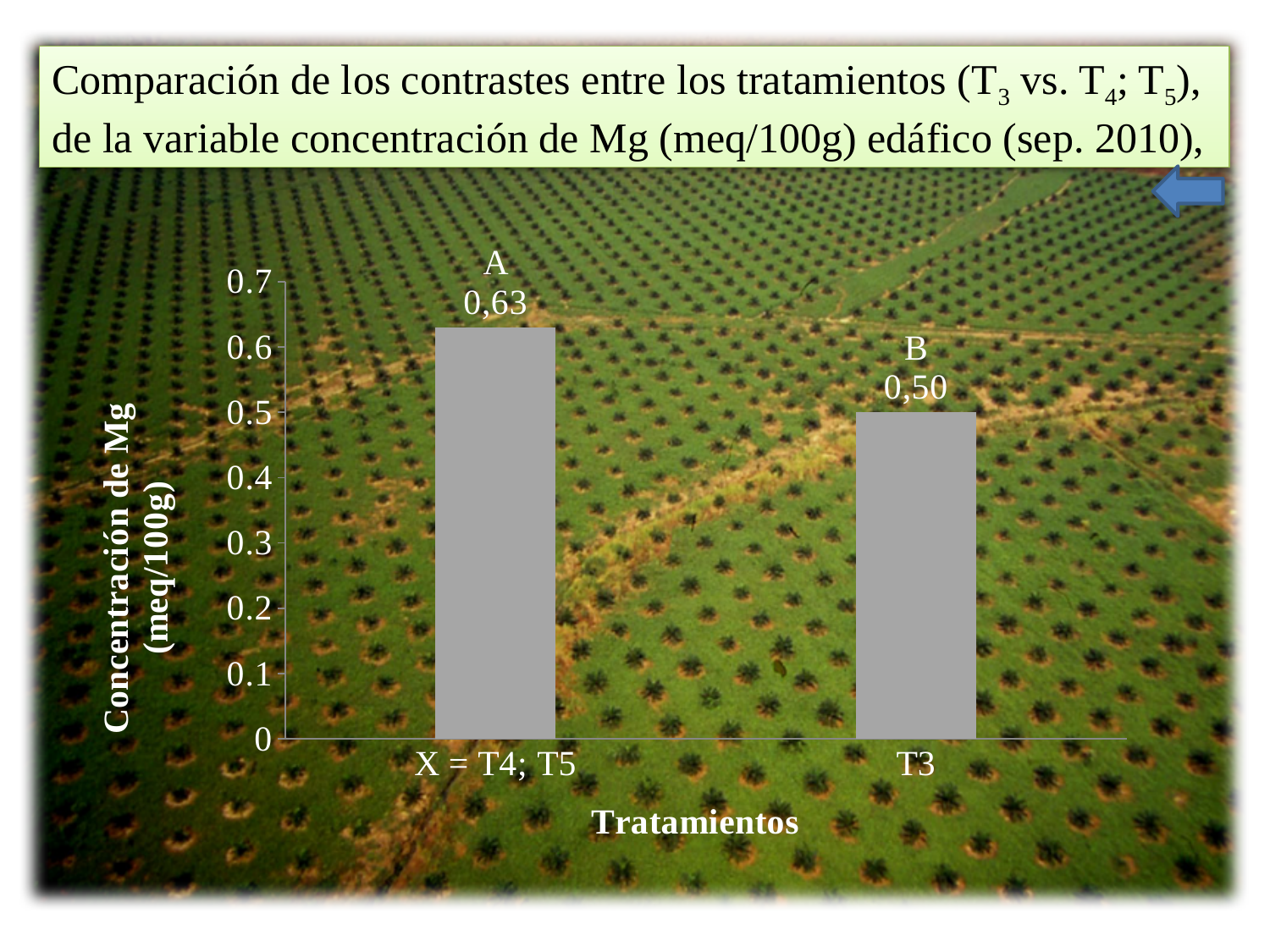
Which has a larger Mg concentration, "X = T4; T5" or T3? X = T4; T5 Is the value for T3 greater or less than 0.6? less What is the Mg concentration value for T3? 0,50 How many categories are shown on the x axis? 2 What is the difference between the Mg concentration for "X = T4; T5" and for T3? 0,13 What statistical group letter is shown above the T3 bar? B What kind of chart is shown on the slide? Bar chart What is the Mg concentration value for the category "X = T4; T5"? 0,63 Is the value for "X = T4; T5" greater or less than 0.5? greater Which category has the lowest Mg concentration? T3 What is the label of the x axis? Tratamientos Which category has the highest Mg concentration? X = T4; T5